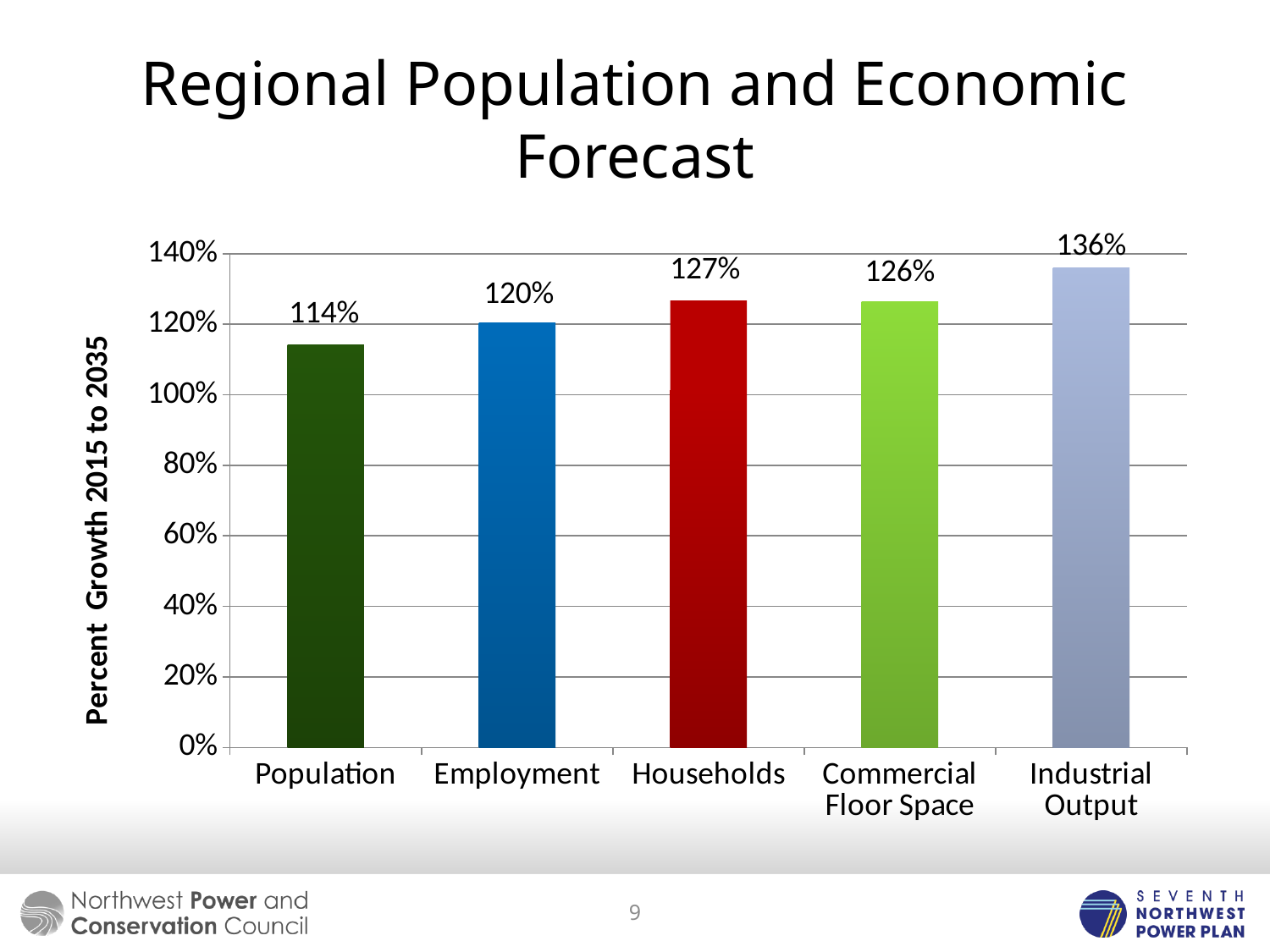
Is the value for Employment greater or less than 100%? greater How many categories are shown on the x axis? 5 What is the value for Commercial Floor Space? 126% What is the label of the vertical axis? Percent Growth 2015 to 2035 Which category has the lowest value? Population Which is larger, the value for Employment or the value for Households? Households What is the difference between the values for Households and Employment? 7% What is the value for Industrial Output? 136% What kind of chart is shown on the slide? bar chart What is the value for Population? 114% Which category has the highest value? Industrial Output What is the difference between the values for Industrial Output and Population? 22%